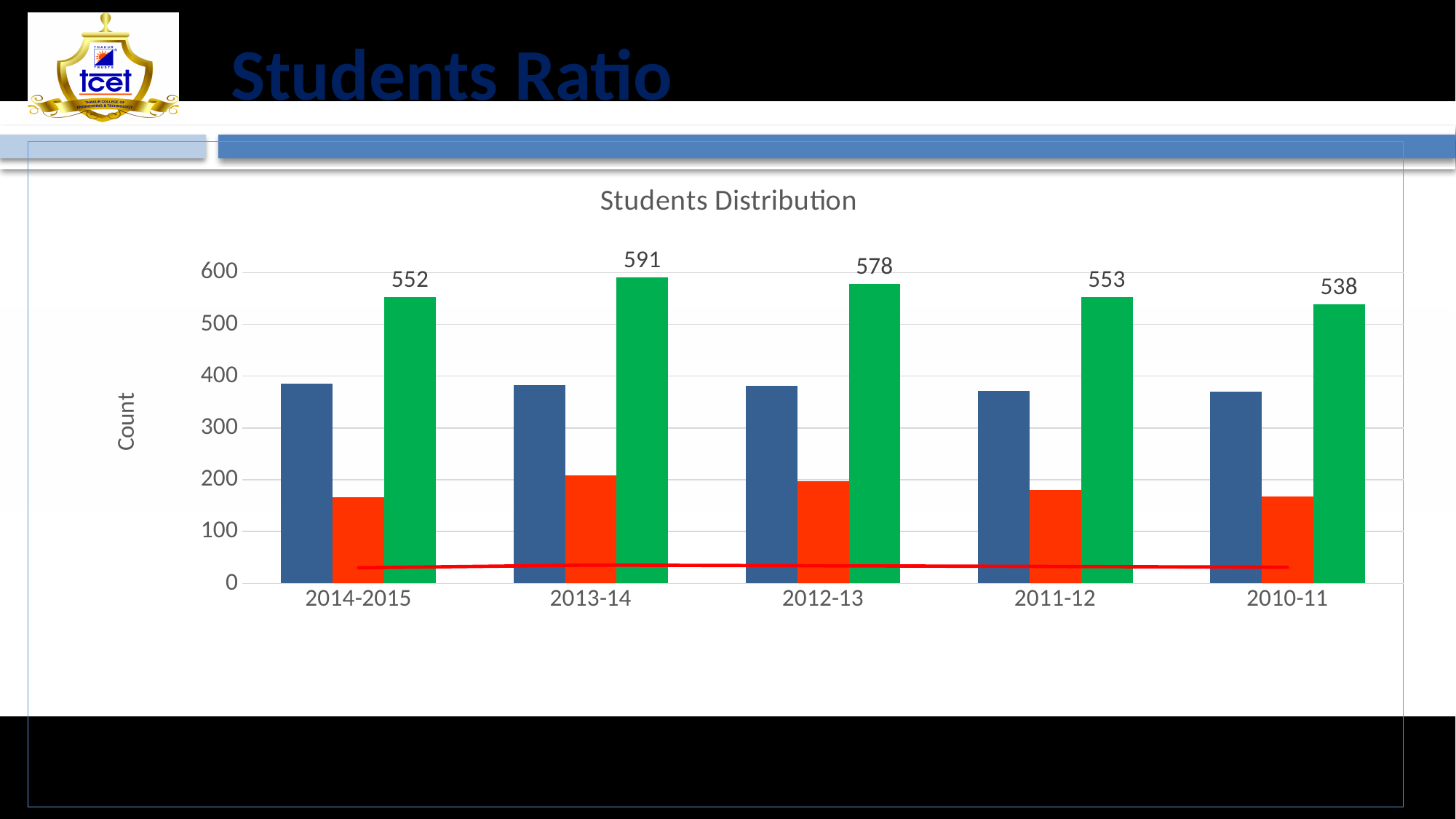
What is the value of the green bar for 2010-11? 538 What is the title of the chart? Students Distribution Which year has the highest green bar value? 2013-14 How many year categories are shown on the x axis? 5 Which year has the lowest green bar value? 2010-11 Is the value of the blue bar for 2014-2015 greater or less than 400? less What is the label on the vertical axis? Count What is the value of the green bar for 2014-2015? 552 What kind of chart is shown on the slide? combination bar and line chart What is the difference between the green bar values for 2013-14 and 2010-11? 53 Which is larger, the green bar for 2012-13 or the green bar for 2011-12? 2012-13 What is the value of the green bar for 2013-14? 591